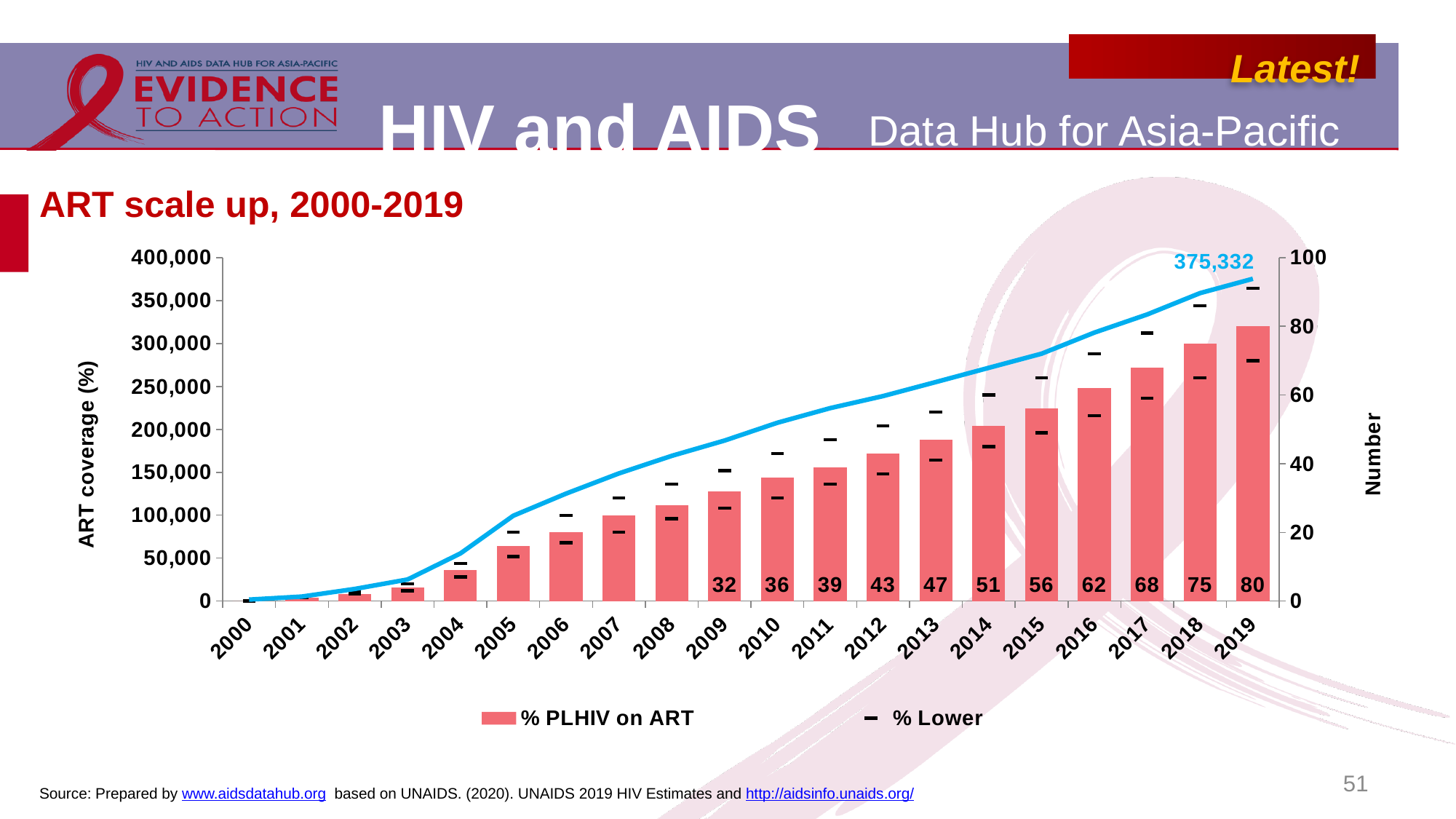
Which year has the larger % PLHIV on ART value, 2017 or 2013? 2017 What is the % PLHIV on ART value shown for 2019? 80 Do the % PLHIV on ART bars rise or fall from 2000 to 2019? rise What is the % PLHIV on ART value shown for 2014? 51 What is the % PLHIV on ART value shown for 2009? 32 Which year has the highest % PLHIV on ART bar? 2019 What is the title of the chart? ART scale up, 2000-2019 By how much did the % PLHIV on ART value increase from 2009 to 2019? 48 How many years are shown along the x axis? 20 What value is labelled on the blue line at 2019? 375,332 How many series does the legend list? 2 What is the difference between the % PLHIV on ART values for 2016 and 2015? 6